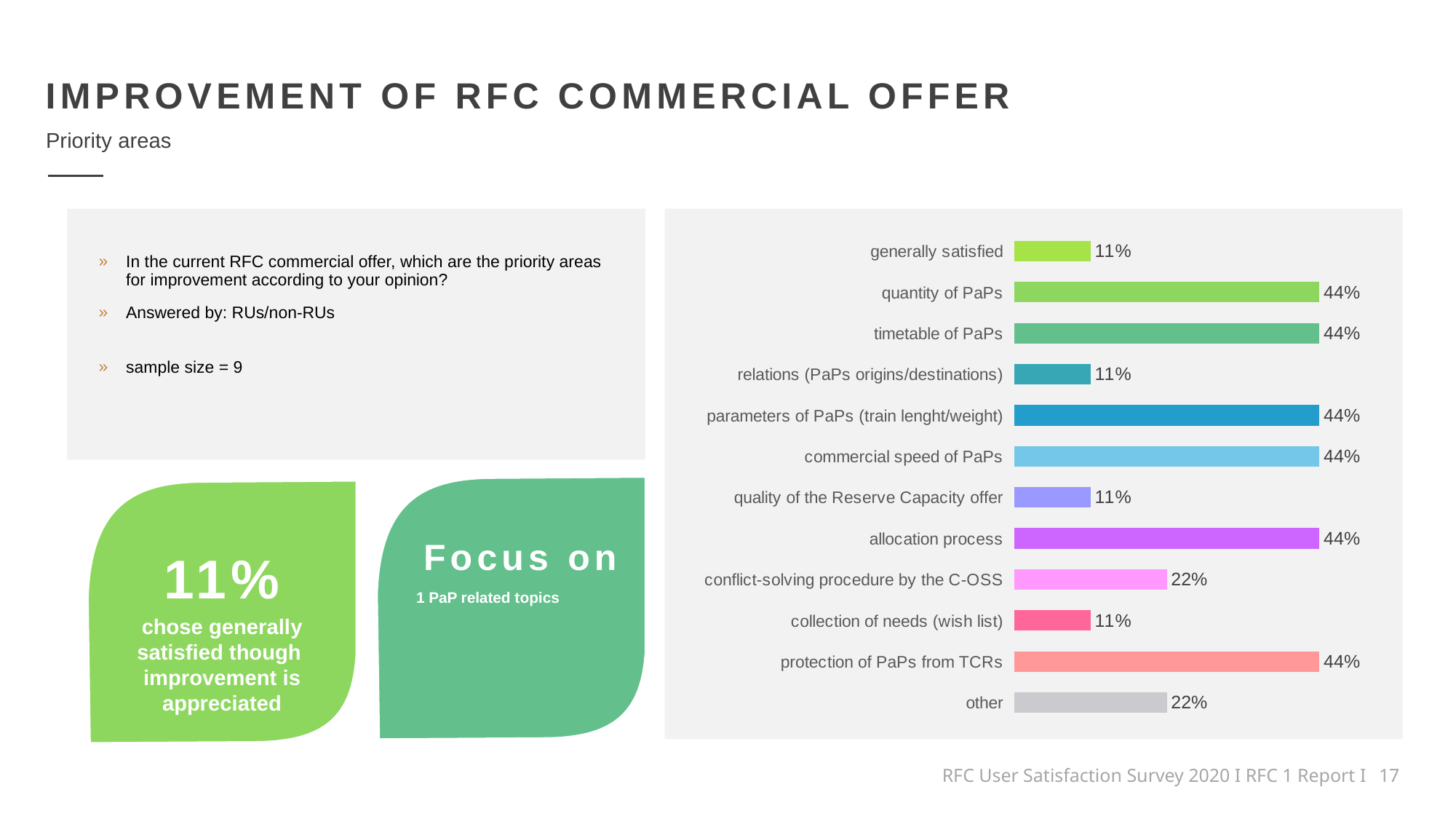
What is the value for 'conflict-solving procedure by the C-OSS'? 22% What is the difference between the value for 'allocation process' and the value for 'other'? 22 percentage points How many categories does the bar chart show? 12 What is the lowest value shown in the chart? 11% What is the value for 'quality of the Reserve Capacity offer'? 11% What is the highest value shown in the chart? 44% What is the difference between the value for 'timetable of PaPs' and the value for 'collection of needs (wish list)'? 33 percentage points What kind of chart is shown on the slide? bar chart What is the value for 'protection of PaPs from TCRs'? 44% What is the value for 'generally satisfied'? 11% What is the value for 'other'? 22% Which is larger: the value for 'quantity of PaPs' or the value for 'conflict-solving procedure by the C-OSS'? quantity of PaPs